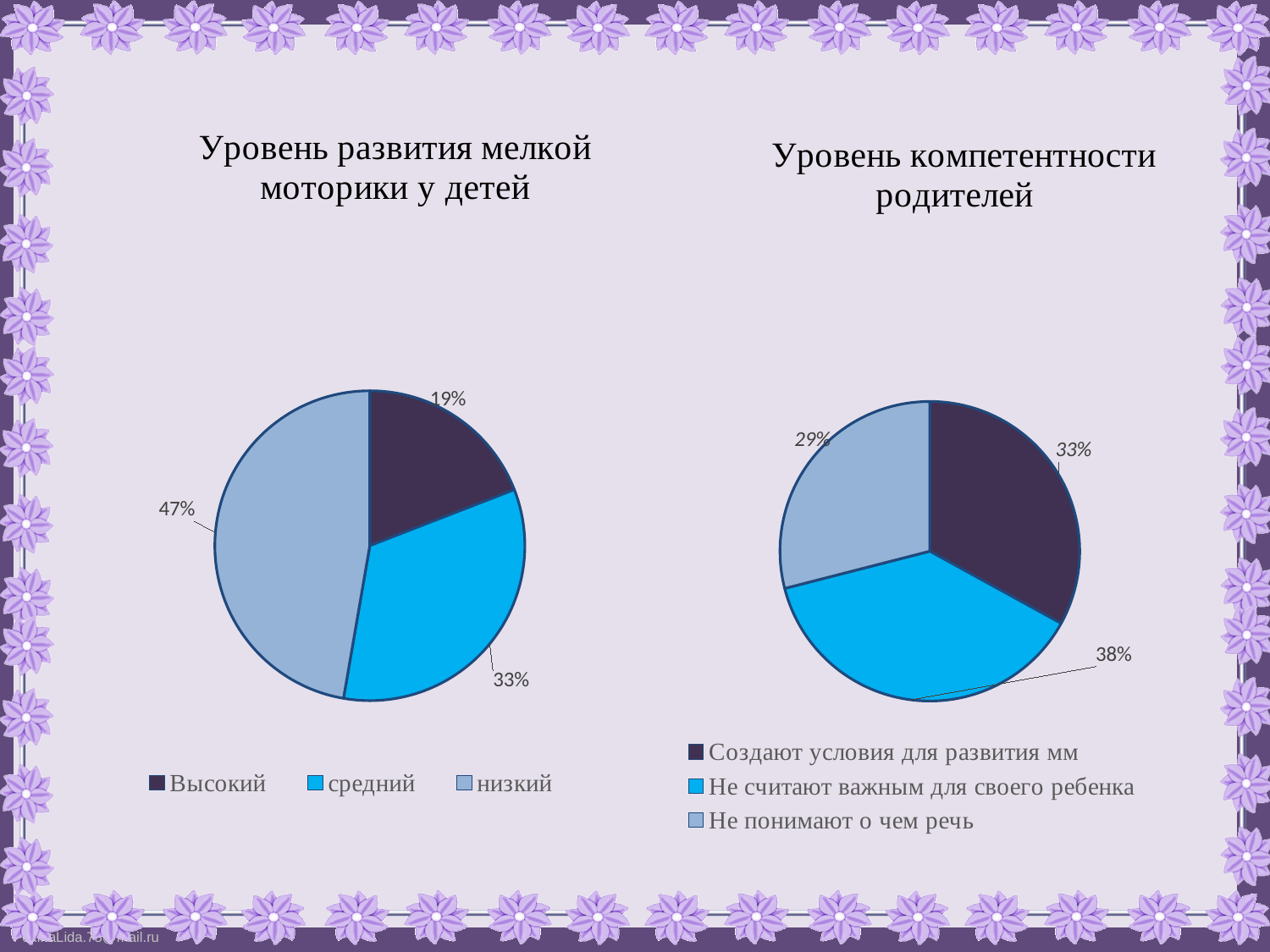
In the chart titled "Уровень компетентности родителей", what share is labelled for "Не понимают о чем речь"? 29% In the chart titled "Уровень компетентности родителей", which is larger: the share for "Создают условия для развития мм" or for "Не понимают о чем речь"? Создают условия для развития мм In the chart titled "Уровень развития мелкой моторики у детей", how many categories does the legend list? 3 How many charts are shown on the slide? 2 In the chart titled "Уровень развития мелкой моторики у детей", what share is labelled for "низкий"? 47% What kind of chart is the one titled "Уровень компетентности родителей"? Pie chart In the chart titled "Уровень развития мелкой моторики у детей", which category has the largest slice? низкий In the chart titled "Уровень развития мелкой моторики у детей", what is the difference between the shares for "низкий" and "средний"? 14% In the chart titled "Уровень развития мелкой моторики у детей", which category has the smallest slice? Высокий In the chart titled "Уровень компетентности родителей", which category has the largest slice? Не считают важным для своего ребенка In the chart titled "Уровень развития мелкой моторики у детей", what share is labelled for "Высокий"? 19% In the chart titled "Уровень компетентности родителей", what share is labelled for "Не считают важным для своего ребенка"? 38%